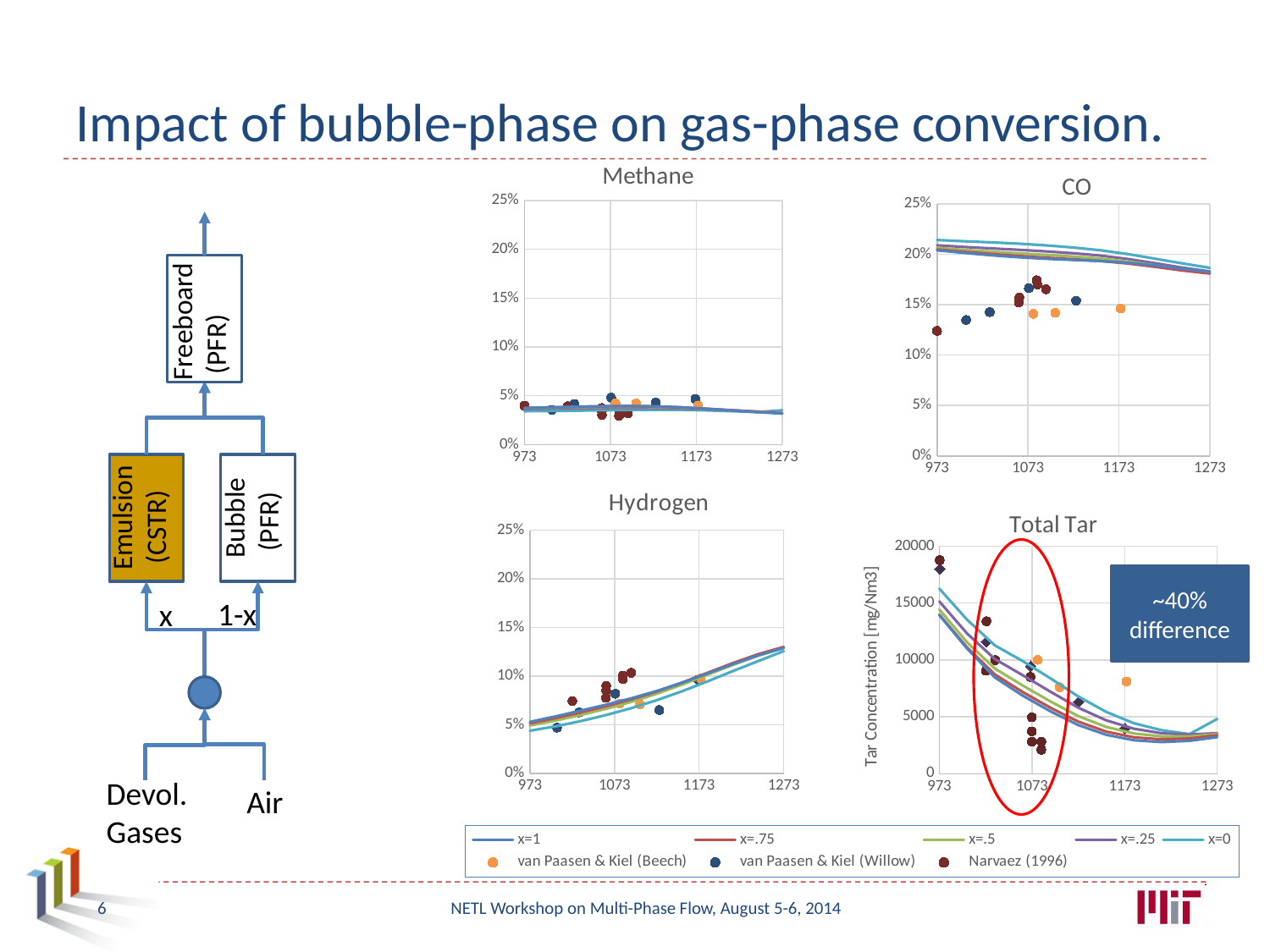
In the Total Tar chart, is the value of the x=1 curve at 1173 greater or less than 5000? less In the Methane chart, are the model curves greater or less than 5% across the temperature range? less What is the y-axis label of the Total Tar chart? Tar Concentration [mg/Nm3] How many charts are shown on the slide? 4 In the CO chart, do the model curves rise or fall as temperature increases from 973 to 1273? fall How many entries does the shared legend at the bottom of the slide list? 8 In the Total Tar chart, do the model curves rise or fall between 973 and 1173? fall What difference is called out in the annotation box on the Total Tar chart? ~40% difference In the CO chart, is the value of the x=0 curve at 973 greater or less than 15%? greater What kind of chart is the Methane chart? line chart In the Hydrogen chart, do the model curves rise or fall as temperature increases from 973 to 1273? rise